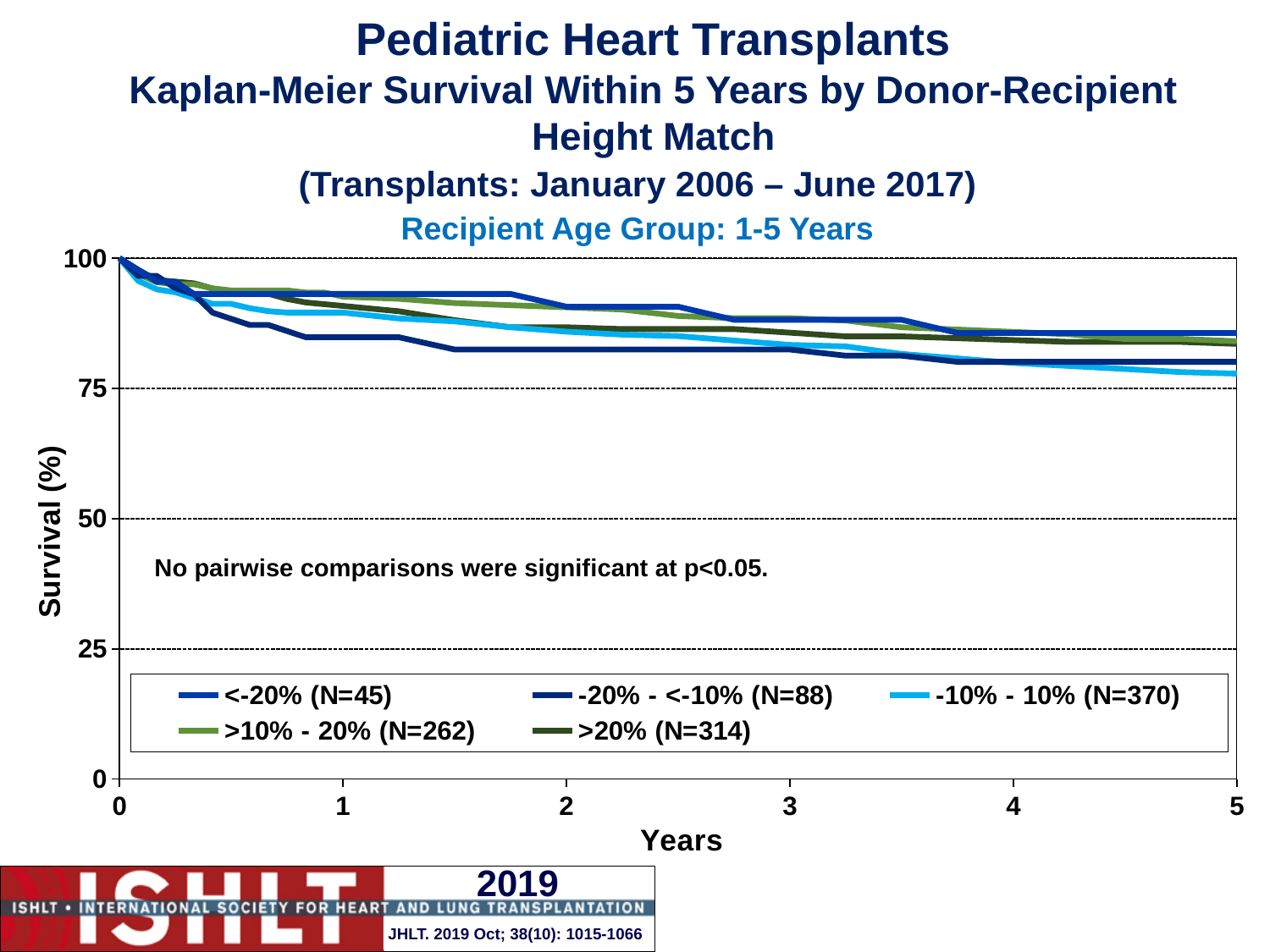
What kind of chart is shown on the slide? line chart What is the highest value shown on the x axis? 5 How many series does the legend list? 5 Is the value for the >10% - 20% (N=262) series at 4 years greater or less than 75? greater Is the value for the <-20% (N=45) series at 1 year greater or less than 75? greater Is the value for the >20% (N=314) series at 3 years greater or less than 100? less Do the survival curves rise or fall as years increase along the x axis? fall What recipient age group does the chart cover? 1-5 Years What is the label of the y axis? Survival (%)